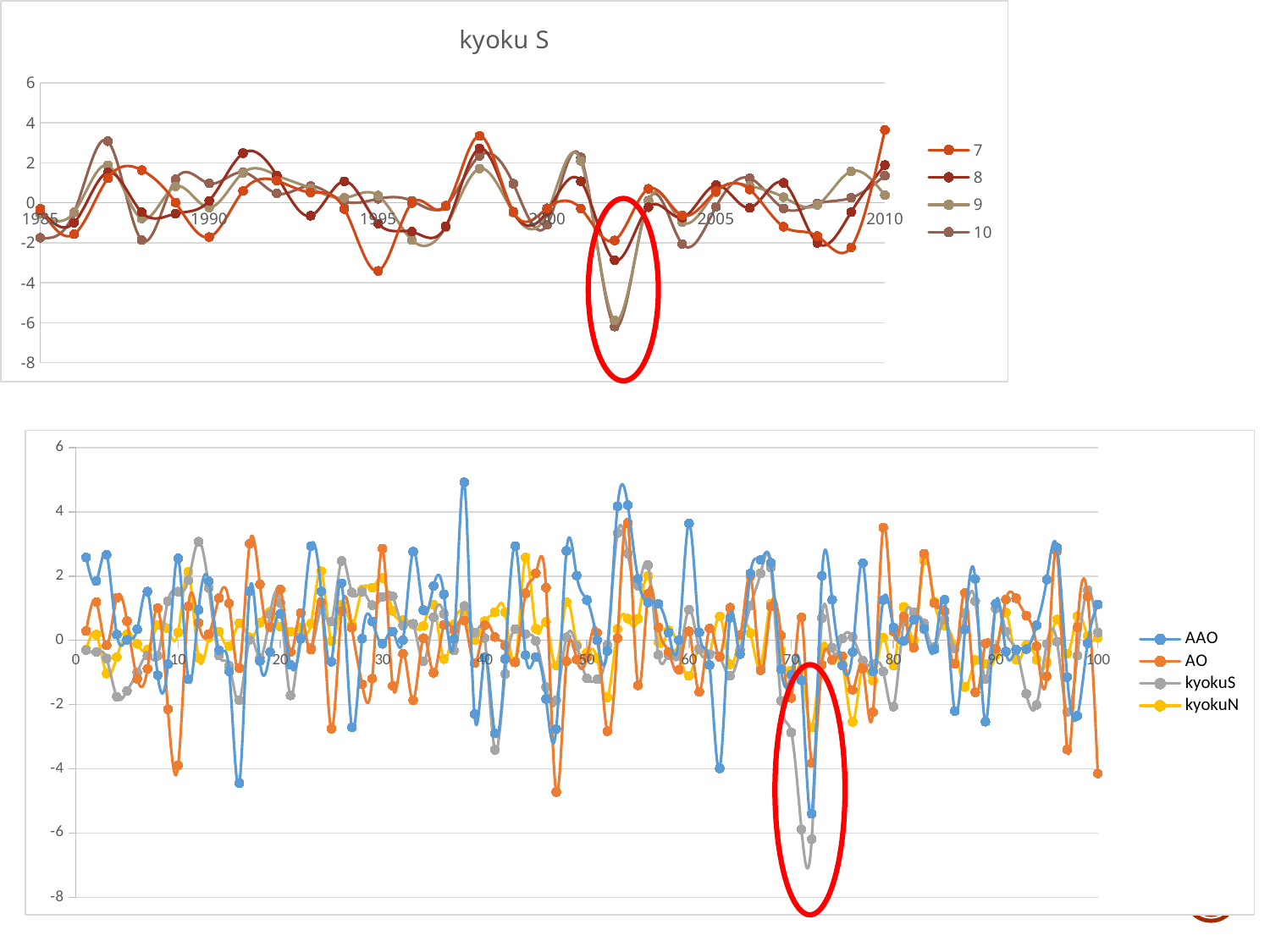
What kind of chart is the bottom chart? line chart How many series does the legend of the bottom chart list? 4 In the top chart (kyoku S), is the value of series 7 at 2010 greater or less than 2? greater In the bottom chart, is the peak value of AAO near x = 39 greater or less than 4? greater In the bottom chart, which series reaches the highest value on the chart? AAO How many series does the legend of the top chart (kyoku S) list? 4 In the top chart (kyoku S), is the lowest value of series 9, around 2002, greater or less than -4? less What kind of chart is the top chart titled kyoku S? line chart In the bottom chart, which series reaches the lowest value on the chart? kyokuS What is the title of the top chart? kyoku S What are the legend entries of the top chart (kyoku S)? 7, 8, 9, 10